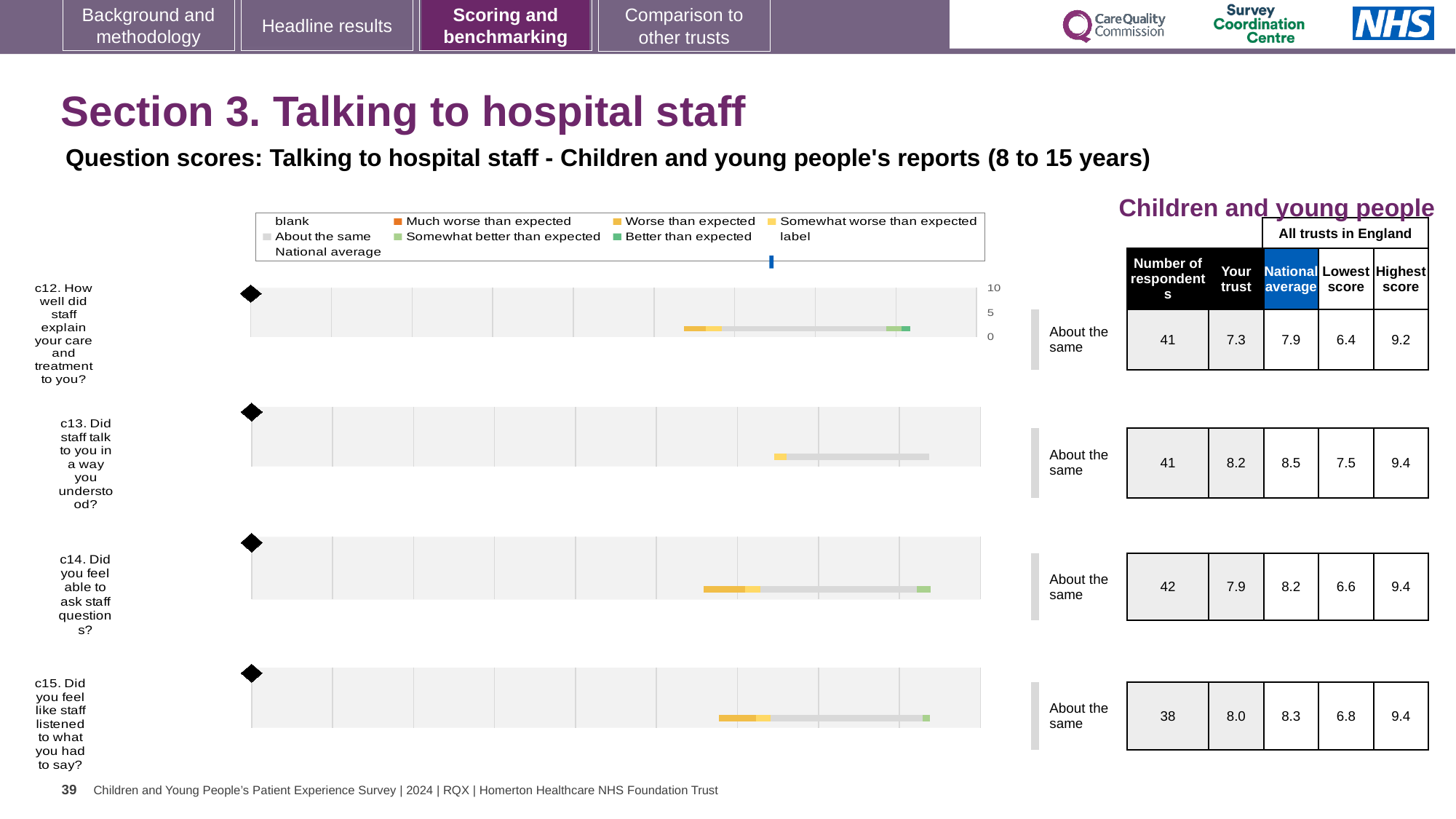
What is the difference between the national average and the 'Your trust' score for c12? 0.6 What is the 'Your trust' score for c12 (How well did staff explain your care and treatment to you?)? 7.3 For c14, which is larger: the 'Your trust' score or the national average? National average Which question has the lowest 'Your trust' score? c12 What is the national average score for c13 (Did staff talk to you in a way you understood?)? 8.5 Which question has the highest 'Your trust' score? c13 What kind of chart is used to show the question scores for c12 to c15? bar chart What benchmark category is shown for c15? About the same What is the highest score across all trusts in England for c14 (Did you feel able to ask staff questions?)? 9.4 What is the lowest score across all trusts in England for c12? 6.4 How many respondents answered c15 (Did you feel like staff listened to what you had to say?)? 38 How many survey questions (c12 to c15) are plotted on the slide? 4